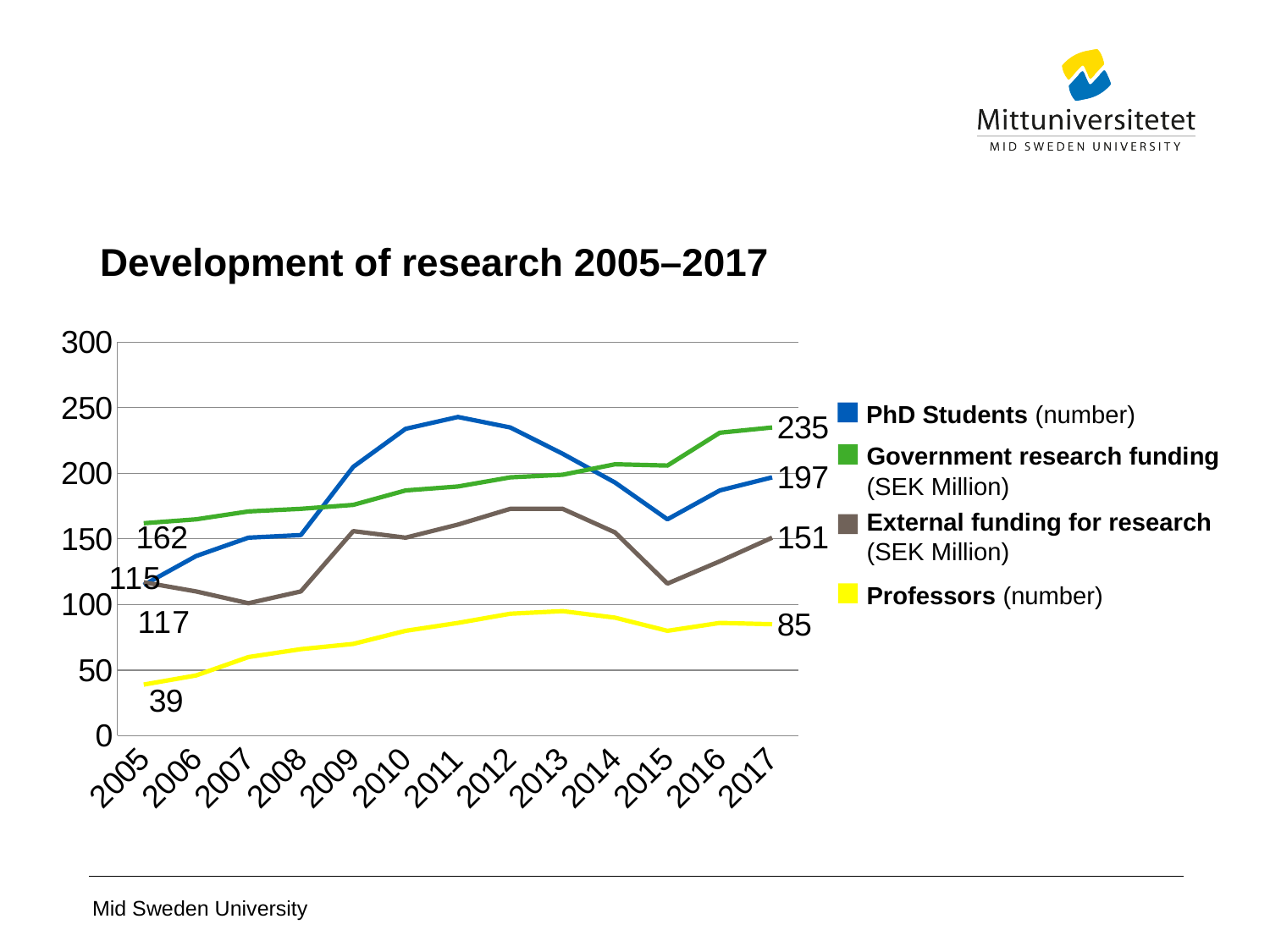
By how much did Government research funding increase from 2005 to 2017? 73 Is the number of PhD Students in 2011 greater or less than 200? greater How many series does the legend list? 4 What is the value for Government research funding in 2005? 162 Which series has the highest value in 2017? Government research funding How many years are plotted along the x axis? 13 What is the number of Professors in 2005? 39 What is the value for External funding for research in 2017? 151 What kind of chart is shown on the slide? line chart What is the value for Government research funding in 2017? 235 What is the title of the chart? Development of research 2005–2017 What is the number of PhD Students in 2017? 197